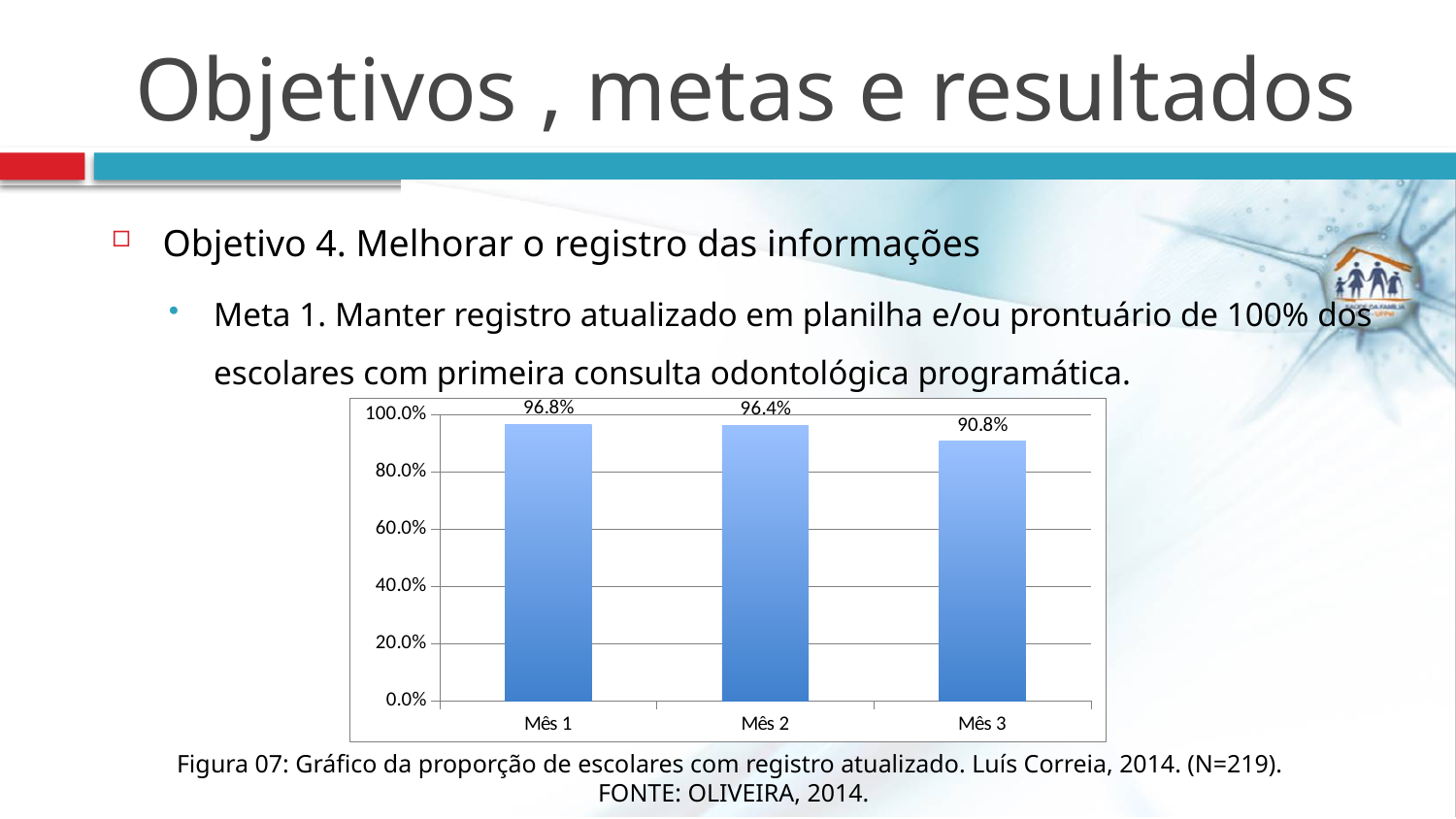
Which month has the lowest value? Mês 3 What is the difference between the values for Mês 2 and Mês 3? 5.6% What is the difference between the values for Mês 1 and Mês 3? 6.0% How many months are shown on the x axis? 3 Which is larger, the value for Mês 2 or the value for Mês 3? Mês 2 What kind of chart is shown on the slide? bar chart Is the value for Mês 3 greater or less than 80.0%? greater What is the value for Mês 3? 90.8% Which month has the highest value? Mês 1 What is the value for Mês 1? 96.8% Do the values rise or fall from Mês 1 to Mês 3? fall What is the value for Mês 2? 96.4%